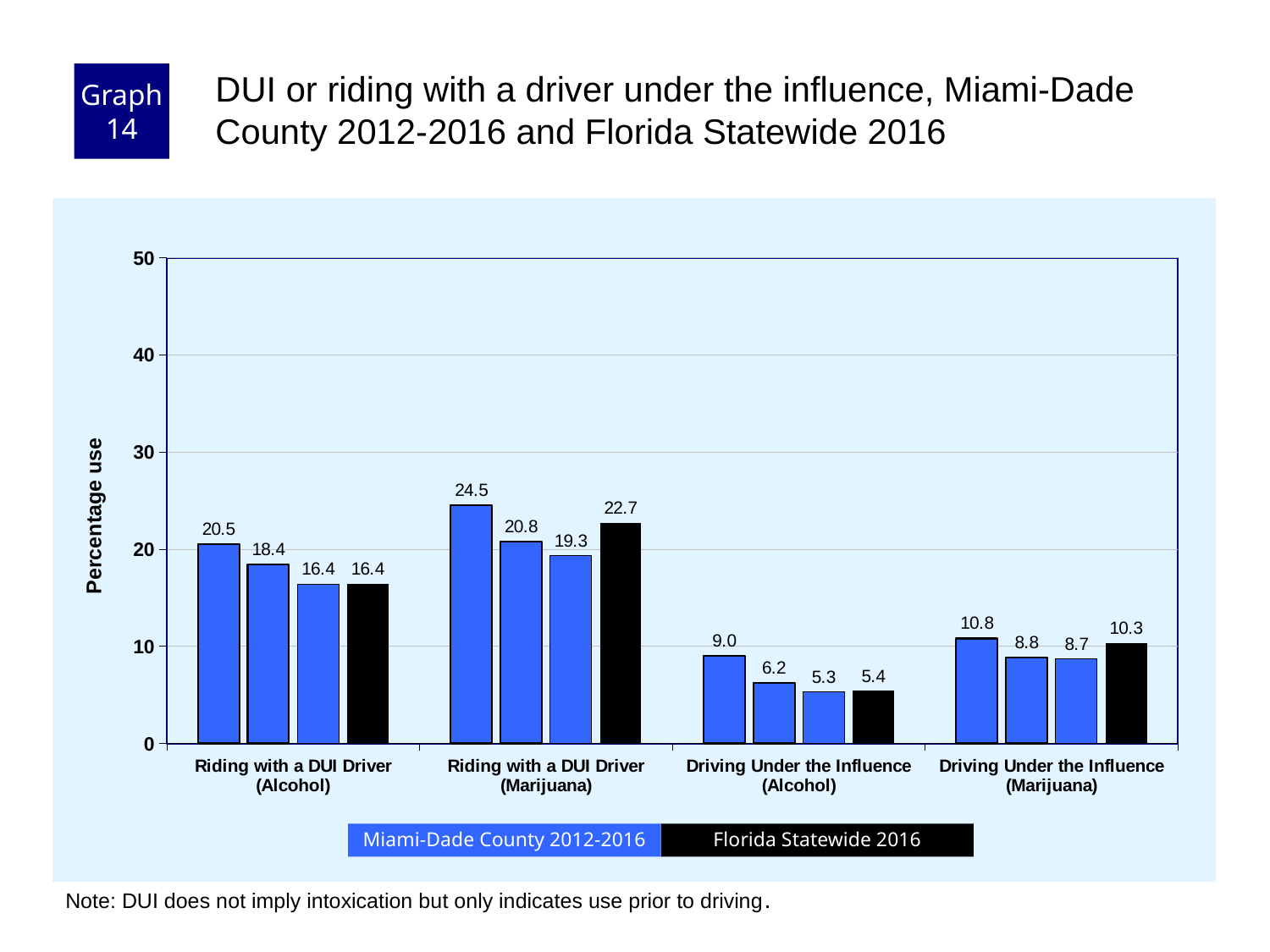
How many categories are shown on the x axis? 4 Which is larger for Florida Statewide 2016: Driving Under the Influence (Marijuana) or Driving Under the Influence (Alcohol)? Driving Under the Influence (Marijuana) Is the Florida Statewide 2016 value for Riding with a DUI Driver (Marijuana) greater or less than 20? greater What is the value of the first (leftmost) Miami-Dade County bar for Driving Under the Influence (Alcohol)? 9.0 What is the lowest value shown on the chart? 5.3 What kind of chart is shown on the slide? bar chart What is the Florida Statewide 2016 value for Driving Under the Influence (Alcohol)? 5.4 What is the difference between the Florida Statewide 2016 values for Riding with a DUI Driver (Marijuana) and Riding with a DUI Driver (Alcohol)? 6.3 Which category contains the tallest bar on the chart? Riding with a DUI Driver (Marijuana) What is the Florida Statewide 2016 value for Riding with a DUI Driver (Marijuana)? 22.7 Within the Riding with a DUI Driver (Alcohol) category, do the Miami-Dade County bars rise or fall from left to right? fall How many series does the legend list? 2